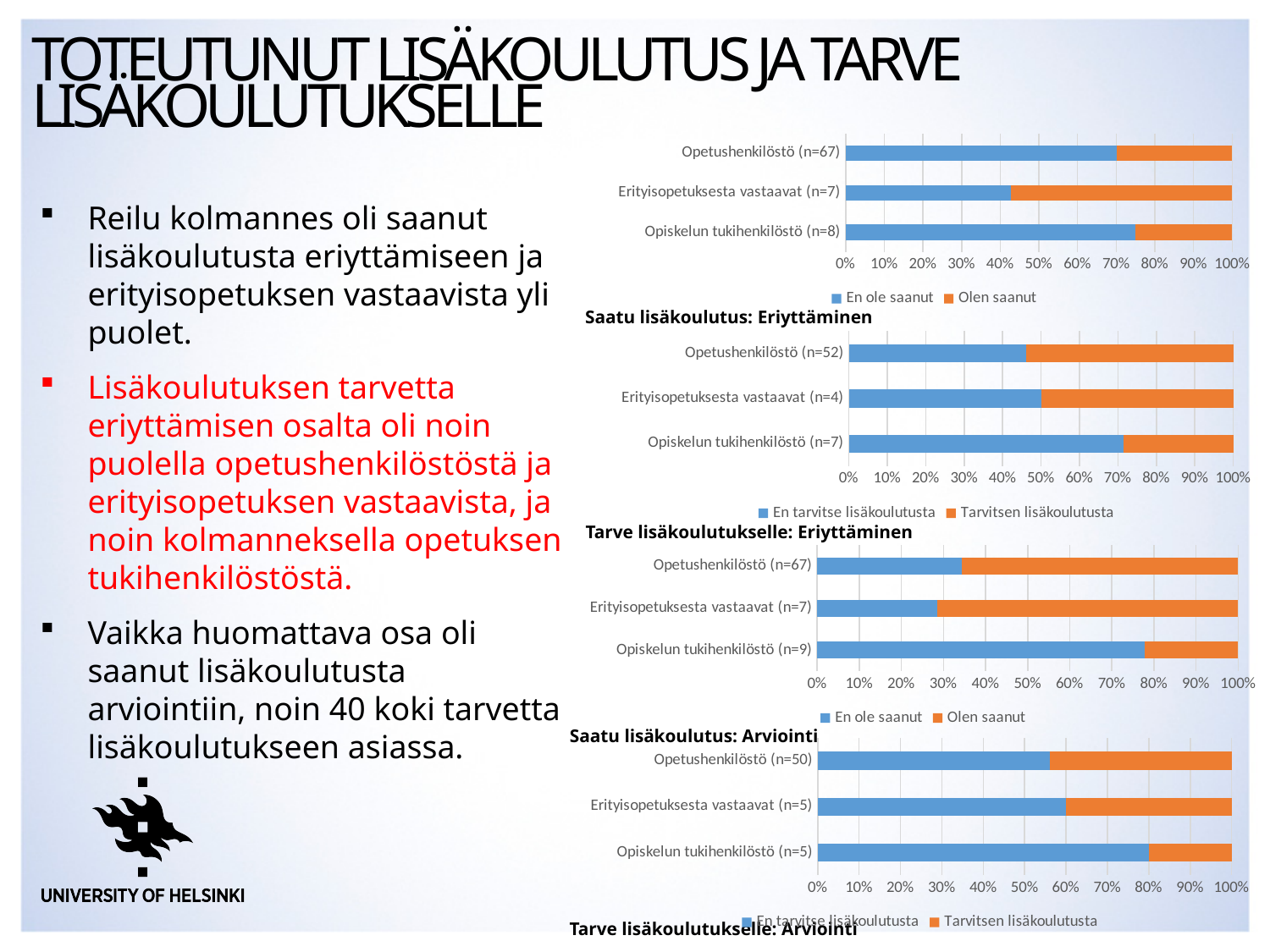
In the chart 'Tarve lisäkoulutukselle: Eriyttäminen', which category has the largest 'En tarvitse lisäkoulutusta' share? Opiskelun tukihenkilöstö (n=7) In the chart 'Saatu lisäkoulutus: Arviointi', which category has the largest 'En ole saanut' share? Opiskelun tukihenkilöstö (n=9) In the chart 'Saatu lisäkoulutus: Arviointi', is the 'En ole saanut' share for Opetushenkilöstö (n=67) greater or less than 40%? less What colour represents 'Olen saanut' in the chart 'Saatu lisäkoulutus: Arviointi'? Orange In the chart 'Tarve lisäkoulutukselle: Eriyttäminen', is the 'En tarvitse lisäkoulutusta' share for Opiskelun tukihenkilöstö (n=7) greater or less than 60%? greater What kind of chart is the top chart, 'Saatu lisäkoulutus: Eriyttäminen'? Stacked bar chart In the bottom chart, 'Tarve lisäkoulutukselle: Arviointi', which is larger: the 'Tarvitsen lisäkoulutusta' share for Opetushenkilöstö (n=50) or for Opiskelun tukihenkilöstö (n=5)? Opetushenkilöstö (n=50) How many categories are shown in the top chart, 'Saatu lisäkoulutus: Eriyttäminen'? 3 In the top chart, 'Saatu lisäkoulutus: Eriyttäminen', is the 'En ole saanut' share for Erityisopetuksesta vastaavat (n=7) greater or less than 50%? less In the top chart, 'Saatu lisäkoulutus: Eriyttäminen', which category has the smallest 'En ole saanut' share? Erityisopetuksesta vastaavat (n=7) How many series does the legend of the chart 'Tarve lisäkoulutukselle: Eriyttäminen' list? 2